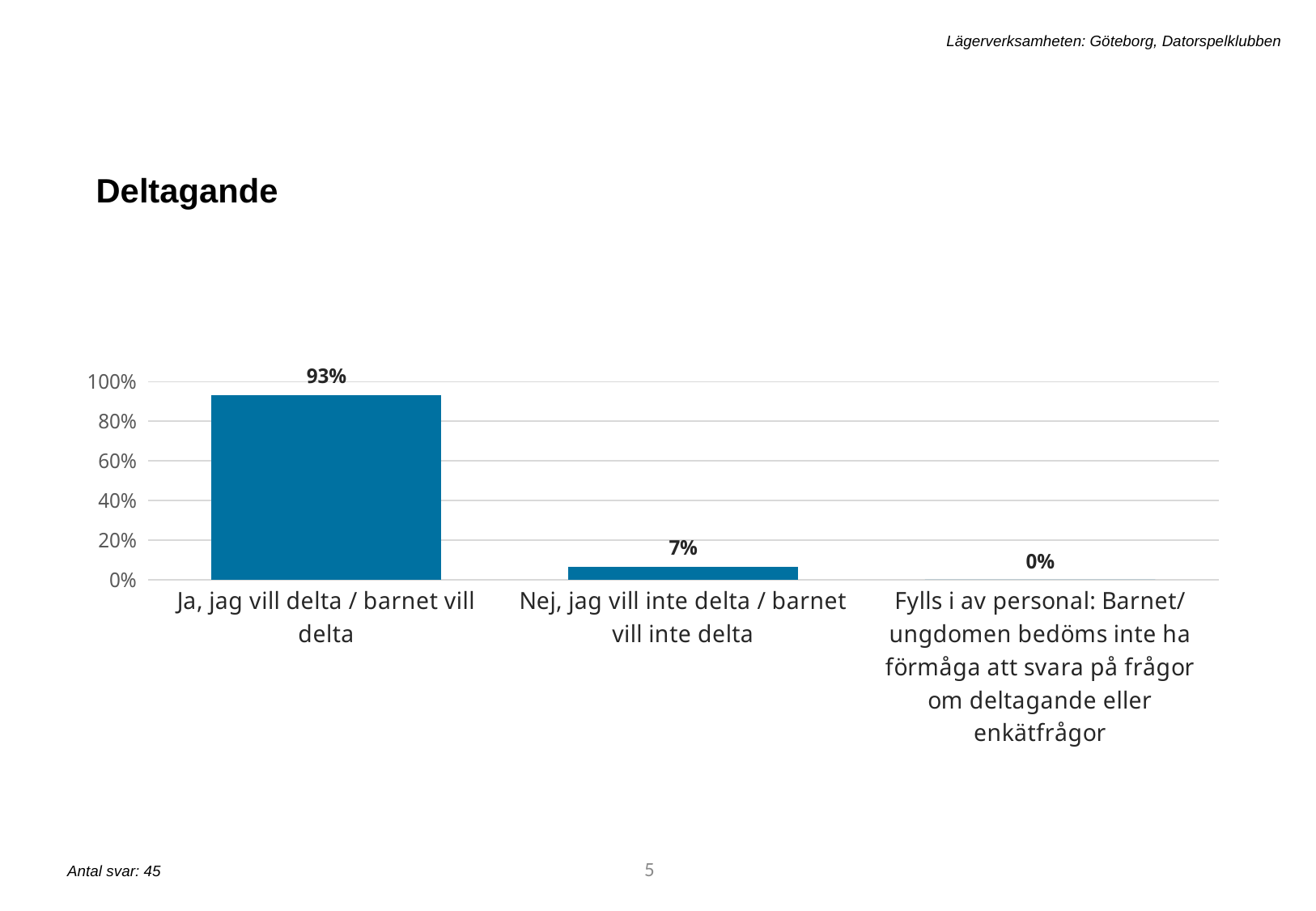
What is the difference between the values for "Ja, jag vill delta / barnet vill delta" and "Nej, jag vill inte delta / barnet vill inte delta"? 86% Is the value for "Ja, jag vill delta / barnet vill delta" greater or less than 80%? greater What kind of chart is shown on the slide? bar chart What is the title of the chart? Deltagande Which category has the highest value? Ja, jag vill delta / barnet vill delta Which is larger: the value for "Ja, jag vill delta / barnet vill delta" or the value for "Nej, jag vill inte delta / barnet vill inte delta"? Ja, jag vill delta / barnet vill delta What is the value for the category "Fylls i av personal: Barnet/ungdomen bedöms inte ha förmåga att svara på frågor om deltagande eller enkätfrågor"? 0% What is the value for "Ja, jag vill delta / barnet vill delta"? 93% What is the value for "Nej, jag vill inte delta / barnet vill inte delta"? 7% Is the value for "Nej, jag vill inte delta / barnet vill inte delta" greater or less than 20%? less How many categories are shown in the chart? 3 Which category has the lowest value? Fylls i av personal: Barnet/ungdomen bedöms inte ha förmåga att svara på frågor om deltagande eller enkätfrågor